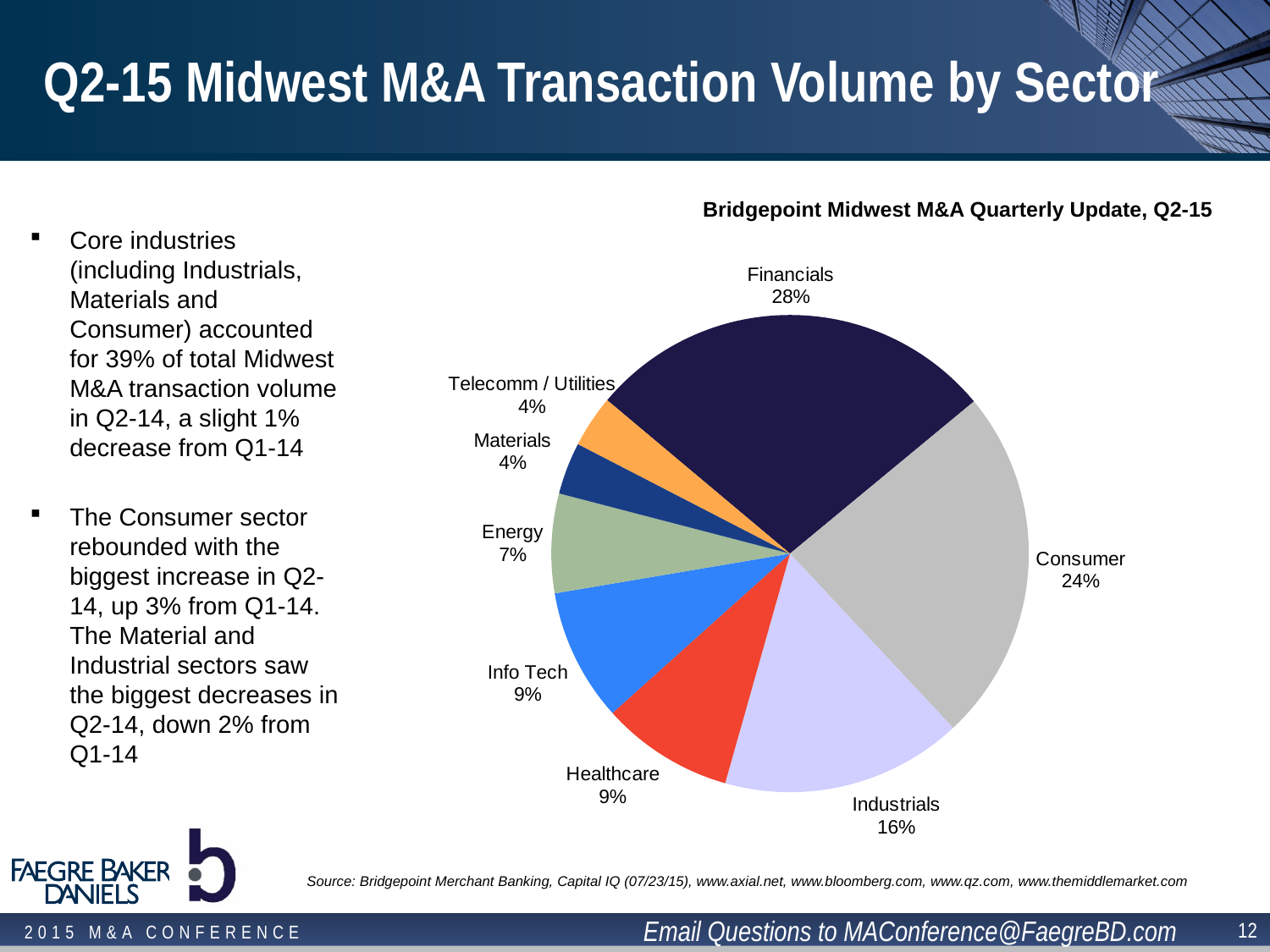
What is the difference in percentage points between Financials and Consumer? 4 What is the title of the chart? Bridgepoint Midwest M&A Quarterly Update, Q2-15 What percentage is shown for the Energy sector? 7% Which is larger, the share for Industrials or the share for Healthcare? Industrials What percentage is shown for Telecomm / Utilities? 4% How many sectors are shown in the pie chart? 8 Which sector has the largest share of the pie? Financials What percentage is shown for the Consumer sector? 24% What share of Midwest M&A transaction volume does the Financials sector account for? 28% What is the difference in percentage points between Industrials and Energy? 9 What percentage is shown for the Industrials sector? 16% What kind of chart is shown on the slide? Pie chart